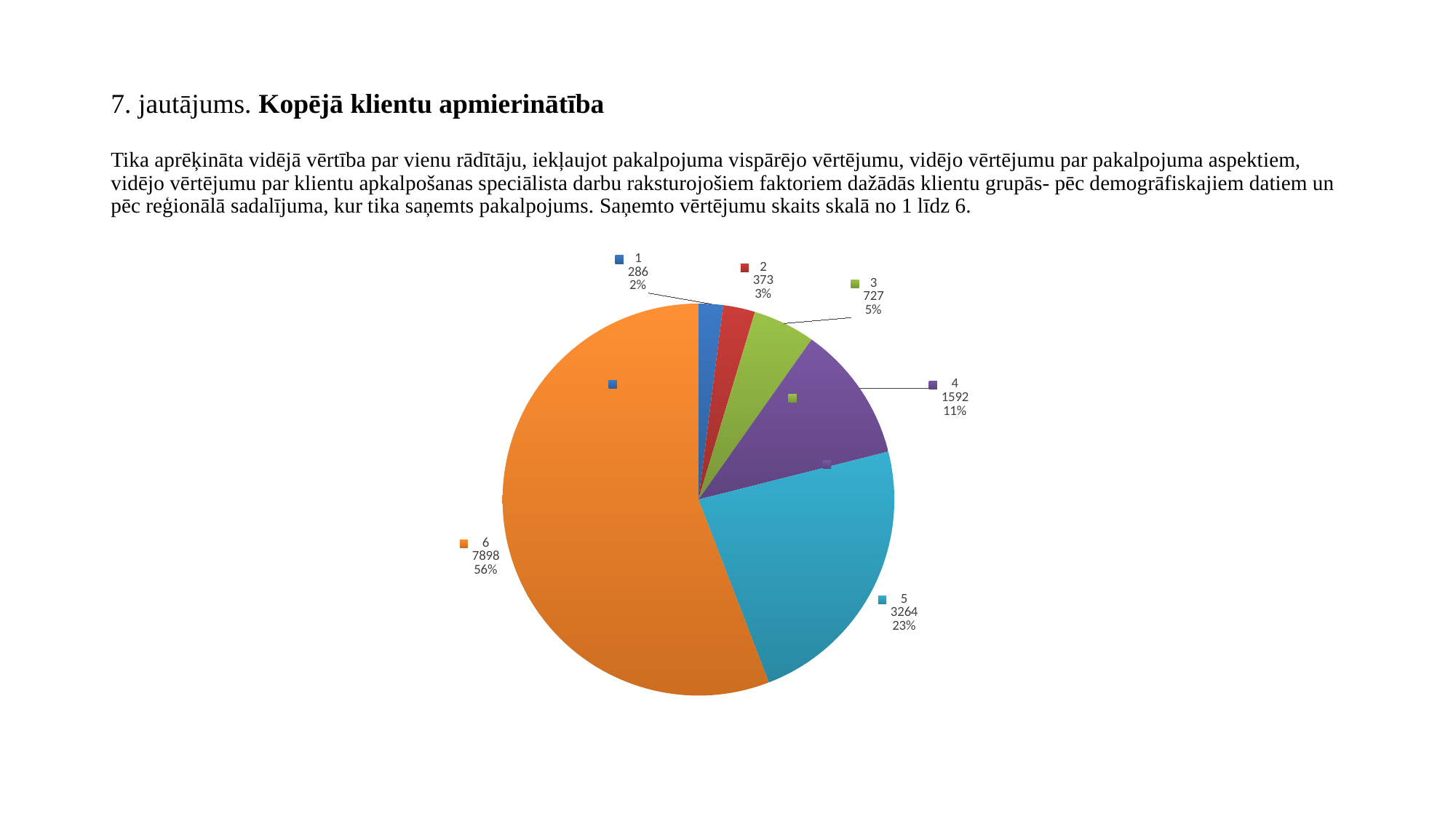
How many slices does the pie chart have? 6 What is the value for category 1? 286 What is the value for category 6? 7898 Which category has the largest slice? 6 What type of chart is shown on the slide? pie chart Which category has the smallest slice? 1 Which is larger, the value for category 2 or category 3? 3 What is the difference between the values for category 6 and category 5? 4634 What is the value for category 5? 3264 What share of the pie does category 3 represent? 5% What is the value for category 4? 1592 What share of the pie does category 5 represent? 23%